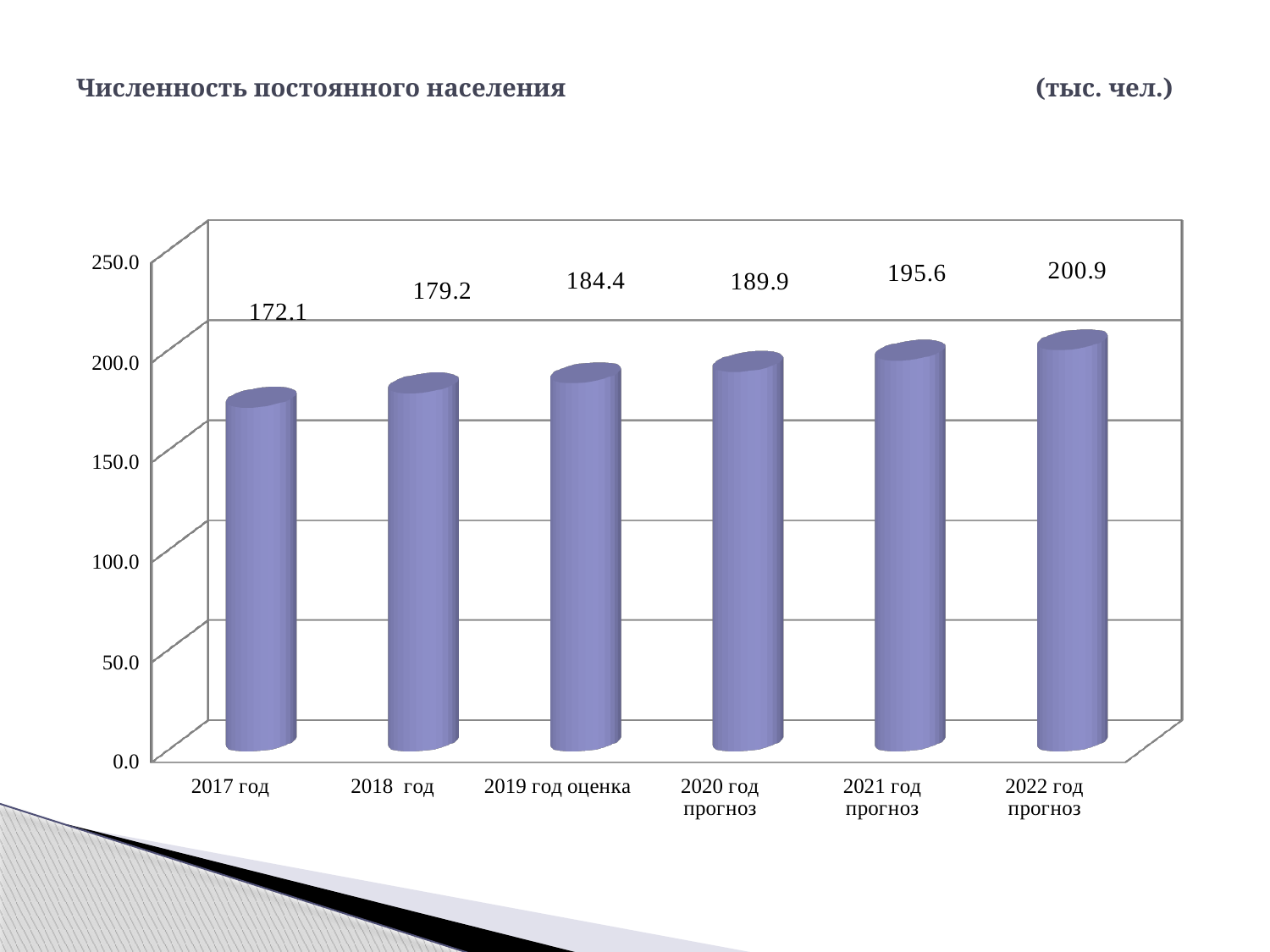
What is the value for 2022 год прогноз? 200.9 What is the value for 2017 год? 172.1 Which is larger, the value for 2018 год or the value for 2020 год прогноз? 2020 год прогноз Do the values rise or fall from 2017 год to 2022 год прогноз? rise Which category has the lowest value? 2017 год Which category has the highest value? 2022 год прогноз What is the difference between the values for 2021 год прогноз and 2020 год прогноз? 5.7 How many categories are shown on the x axis? 6 Is the value for 2021 год прогноз greater or less than 150.0? greater What is the value for 2019 год оценка? 184.4 What is the difference between the values for 2022 год прогноз and 2017 год? 28.8 What kind of chart is this? bar chart